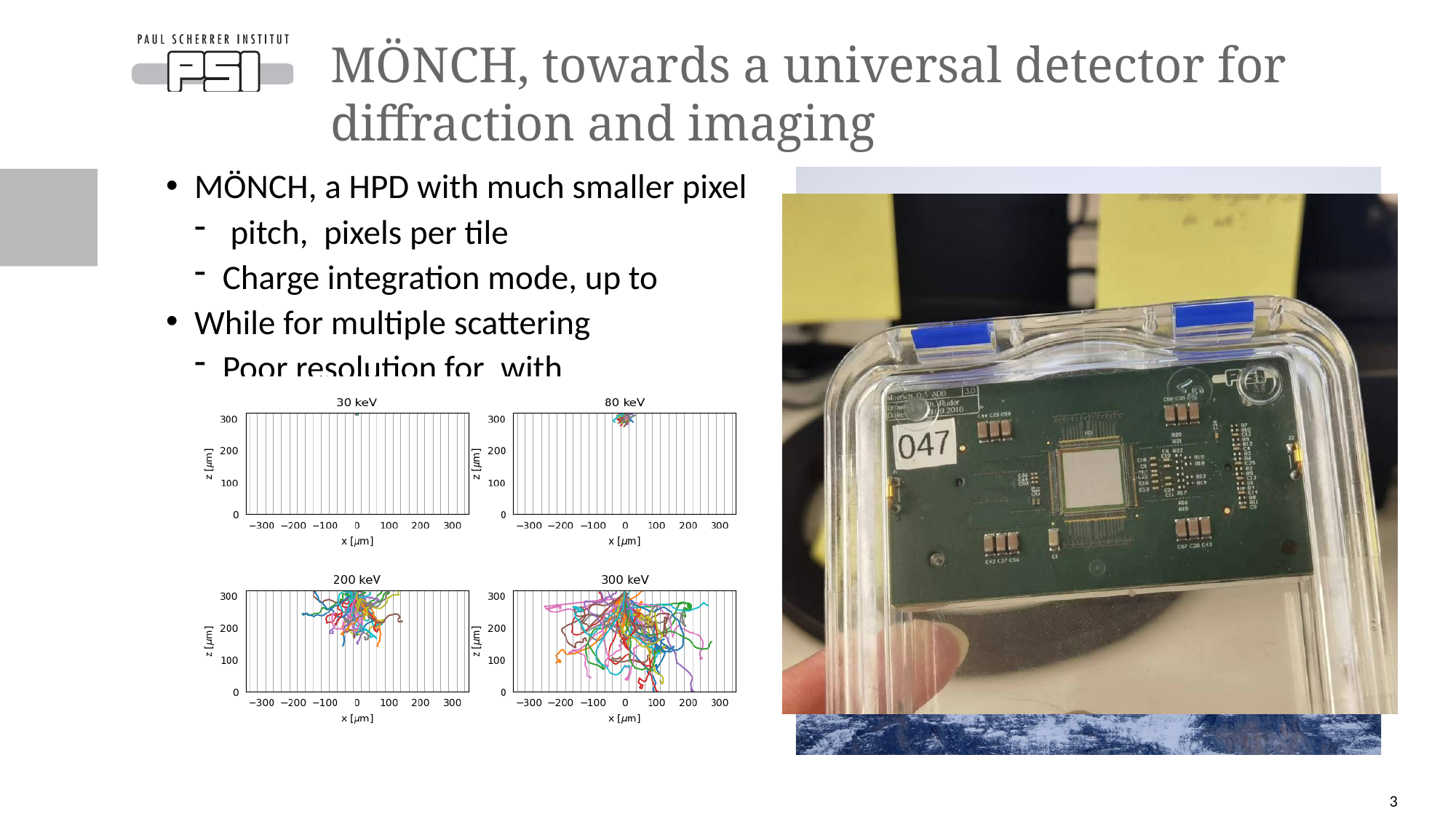
What is the lowest x value marked on the horizontal axis of the plots? −300 What is the highest z value marked on the vertical axis of the plots? 300 Which plot shows the tracks penetrating deepest (reaching the lowest z values)? 300 keV Do the tracks in the 200 keV plot spread more or less than those in the 80 keV plot? more In the 200 keV plot, do the tracks reach below z = 100 μm? No What is the title of the top-left plot? 30 keV In the 300 keV plot, do the tracks reach below z = 100 μm? Yes As the energy increases from 30 keV to 300 keV, does the spread of the tracks increase or decrease? increase Which plot shows the least spread of tracks? 30 keV What is the x-axis label of the plots? x [μm] How many simulation plots are shown on the slide? 4